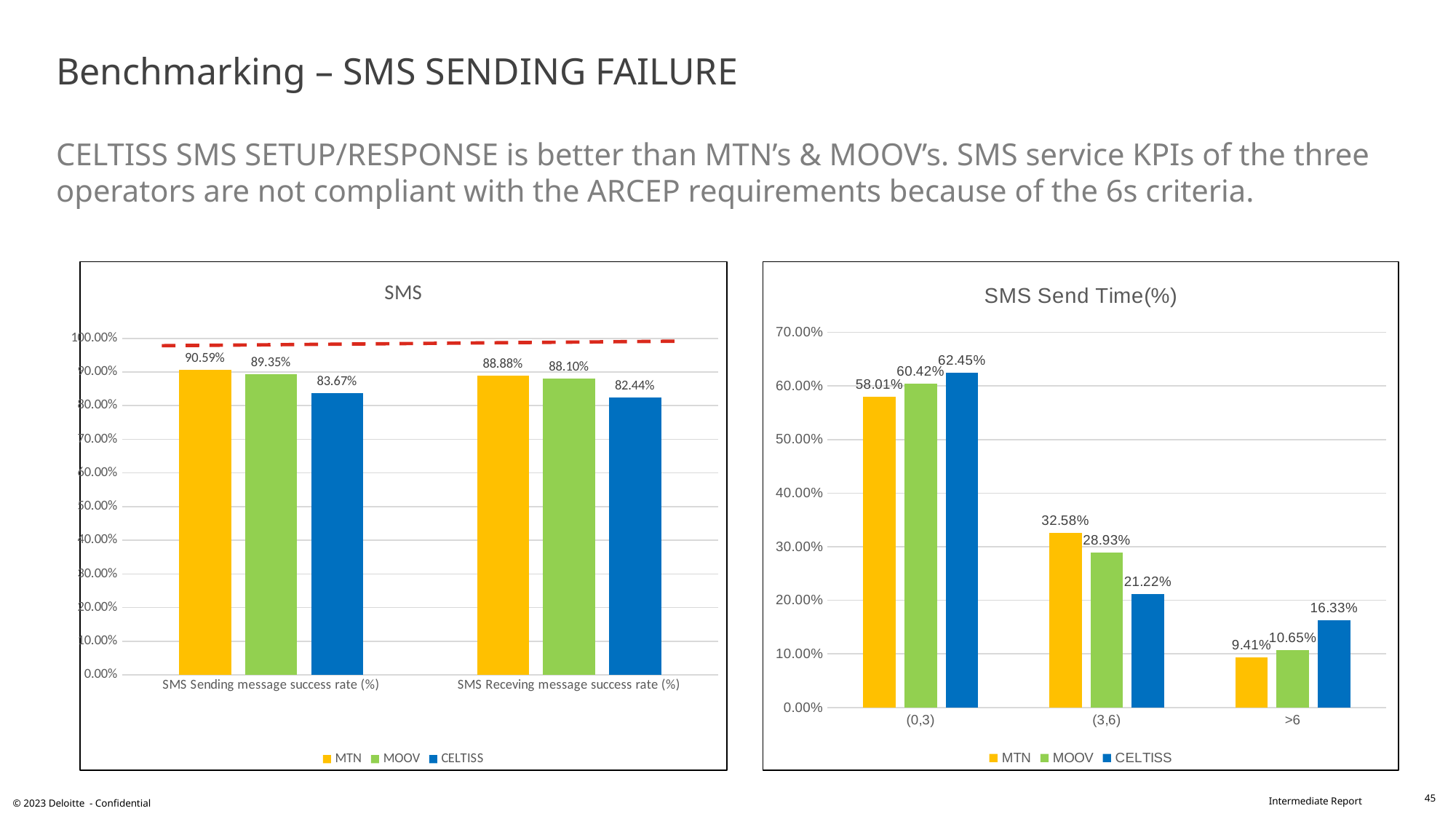
In the "SMS Send Time(%)" chart, is the value for MOOV in the >6 category larger or smaller than the value for CELTISS in the >6 category? smaller In the "SMS" chart, how many series does the legend list? 3 In the "SMS" chart, what is the difference between MTN's and MOOV's SMS Receving message success rate (%)? 0.78% What kind of chart is the "SMS Send Time(%)" chart? Bar chart In the "SMS" chart, what is the SMS Sending message success rate (%) for MTN? 90.59% In the "SMS" chart, which operator has the lowest SMS Sending message success rate (%)? CELTISS In the "SMS Send Time(%)" chart, how many categories are shown on the x axis? 3 In the "SMS Send Time(%)" chart, which operator has the highest value in the (3,6) category? MTN In the "SMS" chart, what is the SMS Receving message success rate (%) for CELTISS? 82.44% In the "SMS Send Time(%)" chart, what is the value for MTN in the >6 category? 9.41% In the "SMS Send Time(%)" chart, what is the difference between MTN's and CELTISS's values in the (3,6) category? 11.36% In the "SMS Send Time(%)" chart, what is the value for CELTISS in the (0,3) category? 62.45%